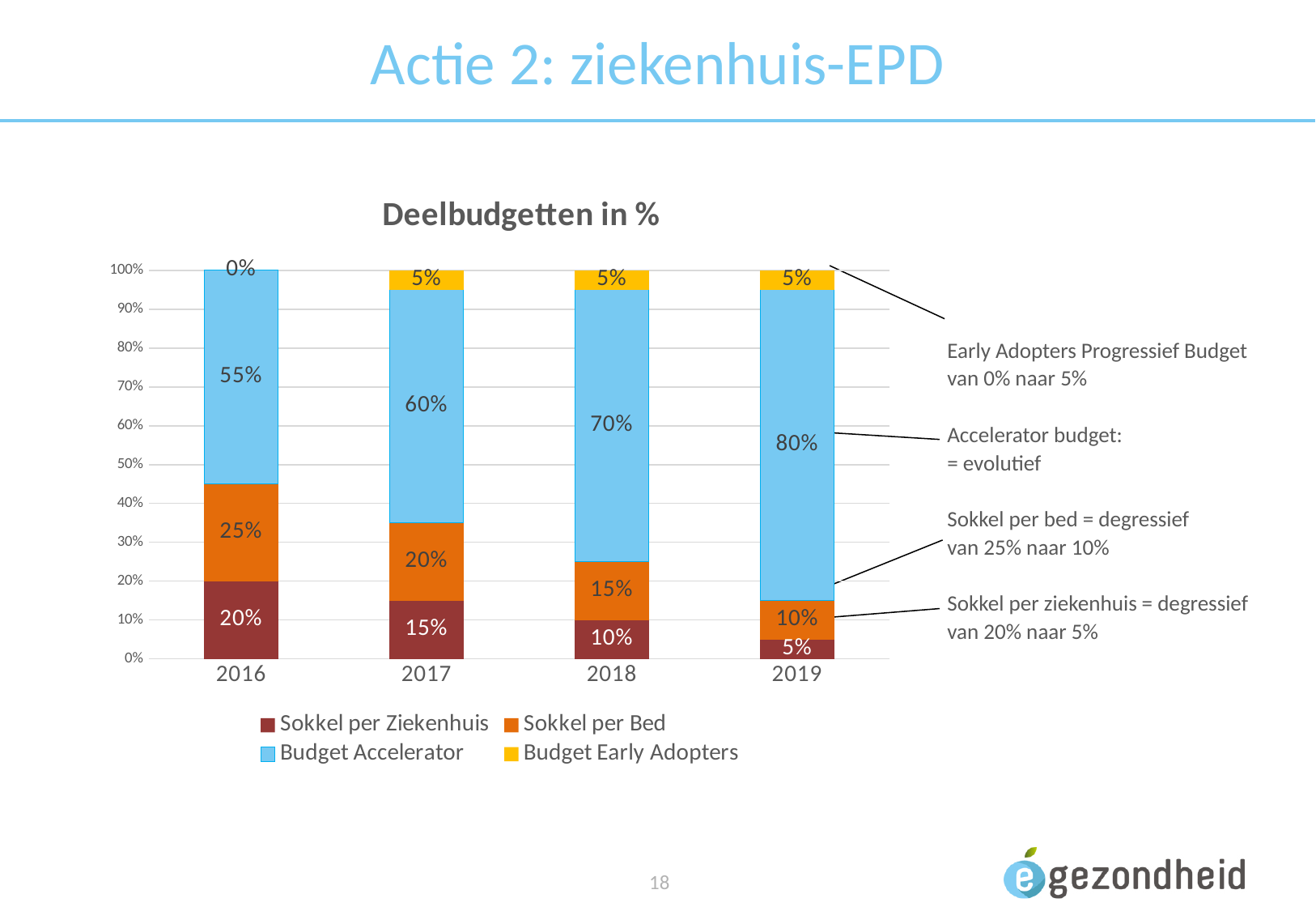
What is the value for Budget Early Adopters in 2017? 5% How many series does the legend list? 4 Which is larger in 2017: Sokkel per Ziekenhuis or Sokkel per Bed? Sokkel per Bed What is the value for Sokkel per Ziekenhuis in 2016? 20% What is the value for Budget Accelerator in 2018? 70% What is the value for Sokkel per Bed in 2019? 10% In which year is the Sokkel per Bed share lowest? 2019 What is the difference between the Budget Accelerator value in 2019 and in 2016? 25% What kind of chart is shown? Stacked bar chart How many years are shown on the x axis? 4 Does the Sokkel per Ziekenhuis share rise or fall from 2016 to 2019? Fall In which year is the Budget Accelerator share highest? 2019